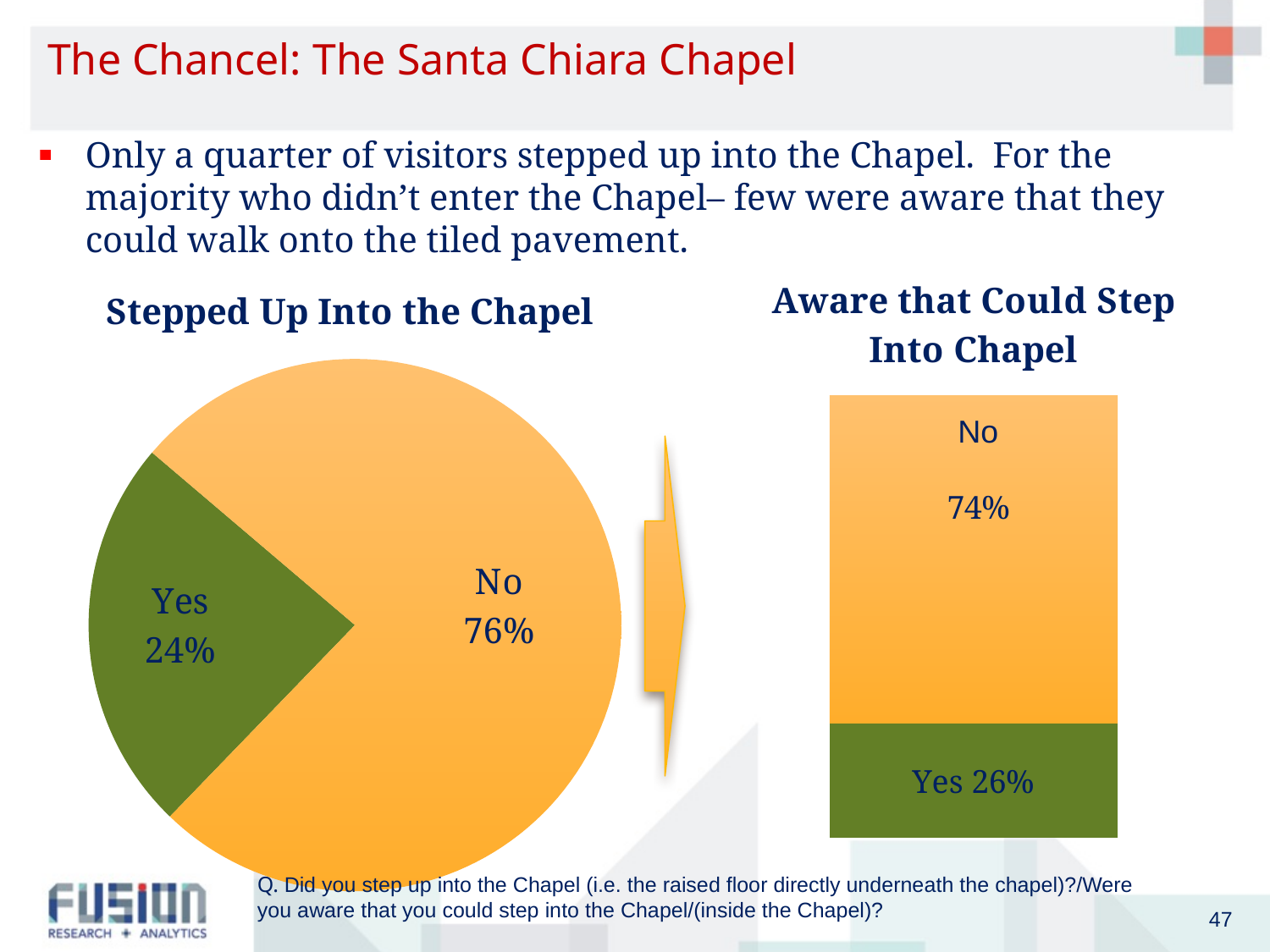
In the 'Stepped Up Into the Chapel' chart, what is the difference between the No and Yes shares? 52% How many slices does the 'Stepped Up Into the Chapel' pie chart have? 2 In the 'Aware that Could Step Into Chapel' chart, what percentage answered No? 74% In the 'Aware that Could Step Into Chapel' chart, what is the difference between the No and Yes values? 48% In the 'Stepped Up Into the Chapel' chart, which response has the larger share? No In the 'Stepped Up Into the Chapel' chart, what percentage of visitors answered Yes? 24% What kind of chart is 'Stepped Up Into the Chapel'? Pie chart In the 'Aware that Could Step Into Chapel' chart, what is the total of the stacked bar? 100% In the 'Stepped Up Into the Chapel' chart, what percentage of visitors answered No? 76% In the 'Aware that Could Step Into Chapel' chart, what percentage answered Yes? 26% What kind of chart is 'Aware that Could Step Into Chapel'? Stacked bar chart In the 'Aware that Could Step Into Chapel' chart, which response has the smaller value? Yes